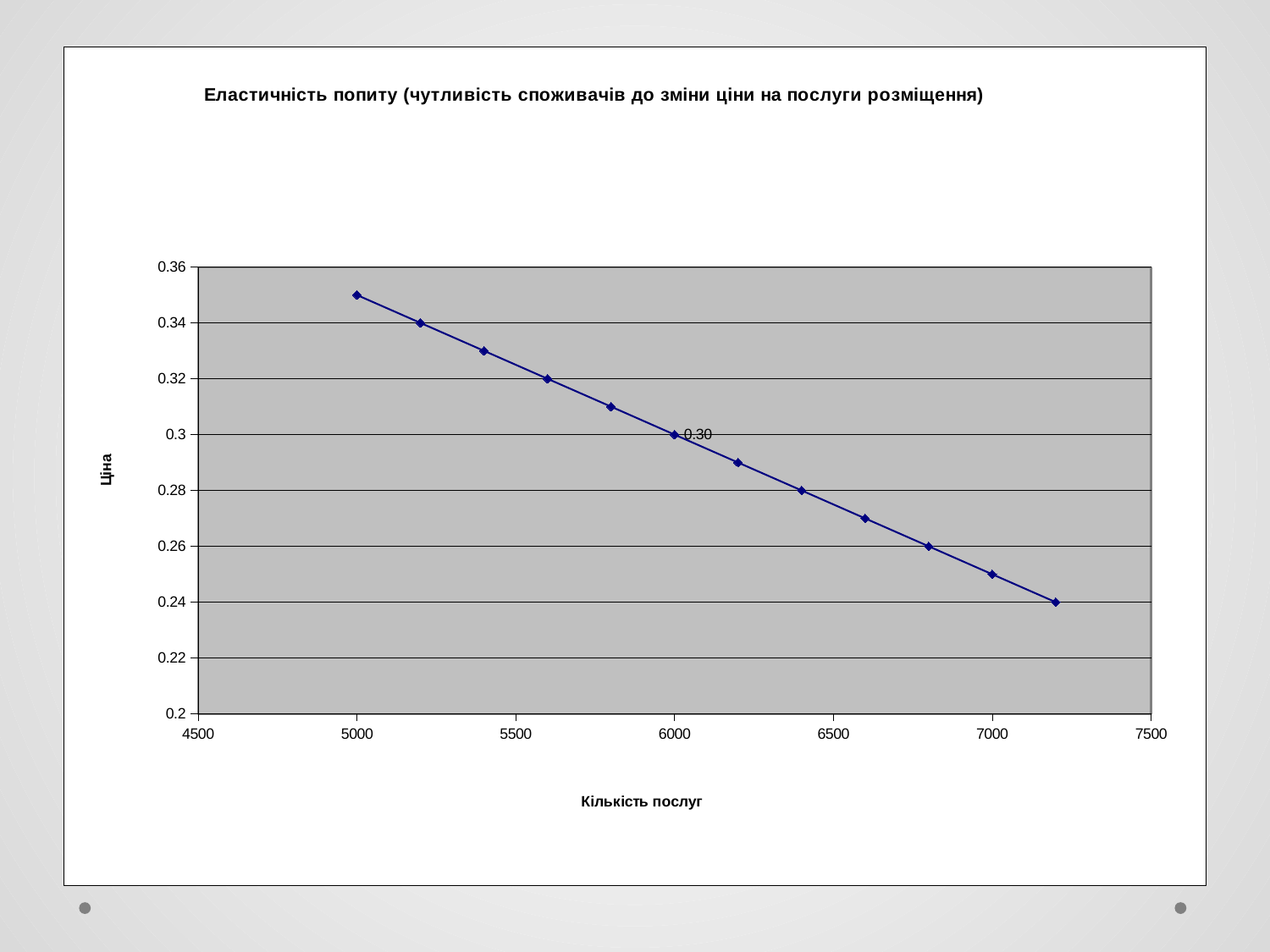
What is the price (Ціна) at 5200 services? 0.34 Do the values rise or fall as the number of services (Кількість послуг) increases along the x axis? fall What type of chart is shown on the slide? line chart Is the price at 5000 services greater or less than 0.34? greater How many data points are plotted on the chart? 12 Which has the higher price: 5400 services or 6600 services? 5400 At which number of services is the price highest? 5000 At which number of services is the price lowest? 7200 Is the price at 7000 services greater or less than 0.26? less What is the title of the vertical axis? Ціна What is the price (Ціна) at 6000 services? 0.30 What is the price (Ціна) at 7200 services? 0.24